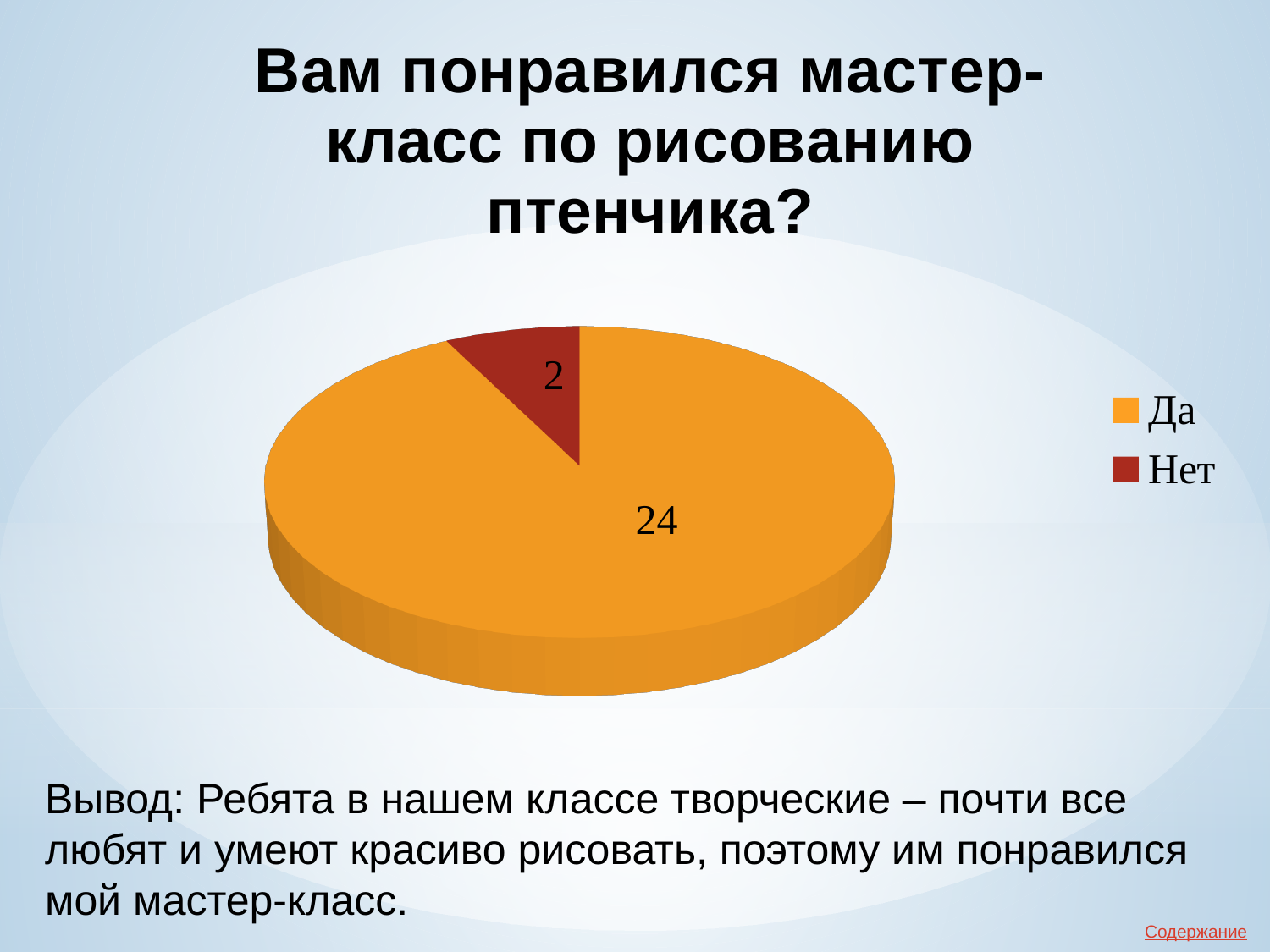
What is the title of the chart? Вам понравился мастер-класс по рисованию птенчика? How many entries does the legend list? 2 Which is larger, the value for "Да" or the value for "Нет"? Да How many people answered "Нет"? 2 What kind of chart is shown on the slide? pie chart How many people answered "Да"? 24 How many slices does the pie chart have? 2 What colour is the "Нет" slice? dark red What is the difference between the number of "Да" and "Нет" answers? 22 What is the total of all slices in the pie chart? 26 Which answer has the largest slice of the pie? Да Which answer has the smallest slice of the pie? Нет